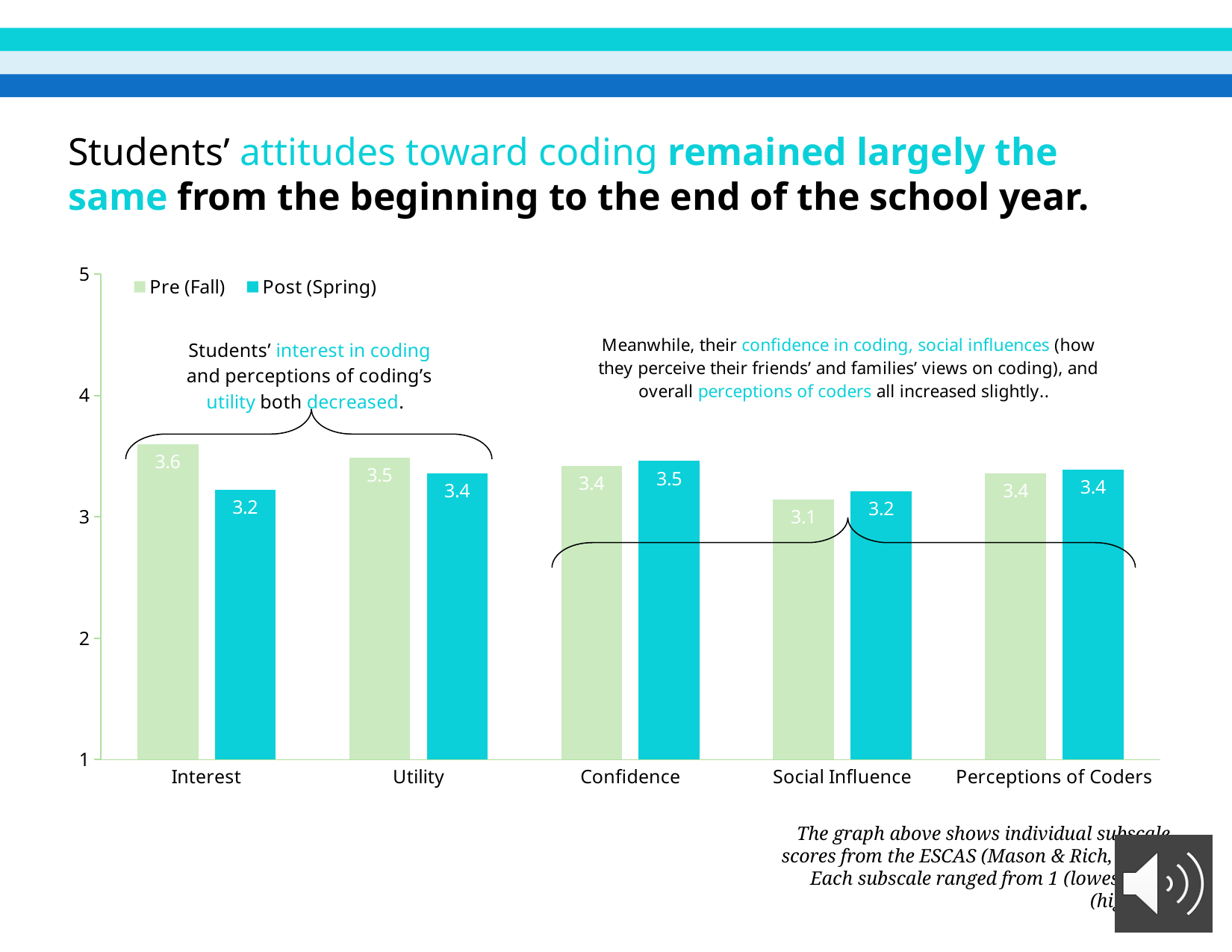
How many categories are shown on the x axis? 5 Which category has the highest Pre (Fall) value? Interest Which category has the lowest Pre (Fall) value? Social Influence How many series does the legend list? 2 What is the difference between the Pre (Fall) and Post (Spring) values for Interest? 0.4 Which category has the lowest Post (Spring) value? Interest and Social Influence What kind of chart is shown on the slide? Bar chart What is the Pre (Fall) value for Interest? 3.6 What is the Post (Spring) value for Confidence? 3.5 Is the Pre (Fall) value for Social Influence greater or less than 3? greater What is the Post (Spring) value for Social Influence? 3.2 For Utility, which is larger: the Pre (Fall) value or the Post (Spring) value? Pre (Fall)